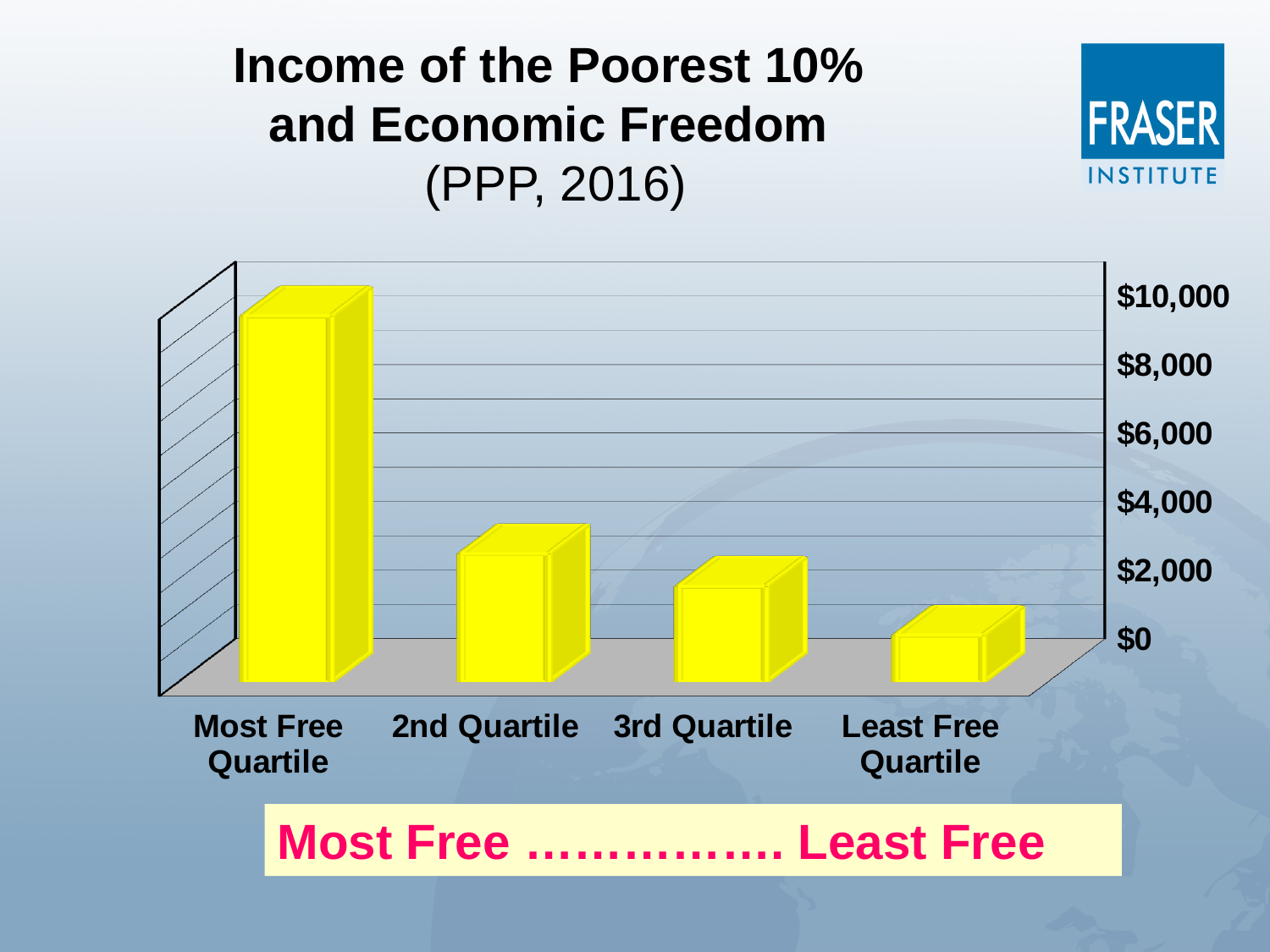
Which is larger, the value for the 2nd Quartile or the 3rd Quartile? 2nd Quartile Is the value for the Least Free Quartile greater or less than $2,000? less Which is larger, the value for the Most Free Quartile or the 2nd Quartile? Most Free Quartile Is the value for the 3rd Quartile greater or less than $4,000? less Which quartile has the highest income of the poorest 10%? Most Free Quartile What kind of chart is shown on the slide? bar chart Do the values rise or fall moving from the Most Free Quartile to the Least Free Quartile? fall Is the value for the Most Free Quartile greater or less than $8,000? greater What is the title of the chart on the slide? Income of the Poorest 10% and Economic Freedom (PPP, 2016) How many categories (quartiles) are plotted in the chart? 4 Which quartile has the lowest income of the poorest 10%? Least Free Quartile